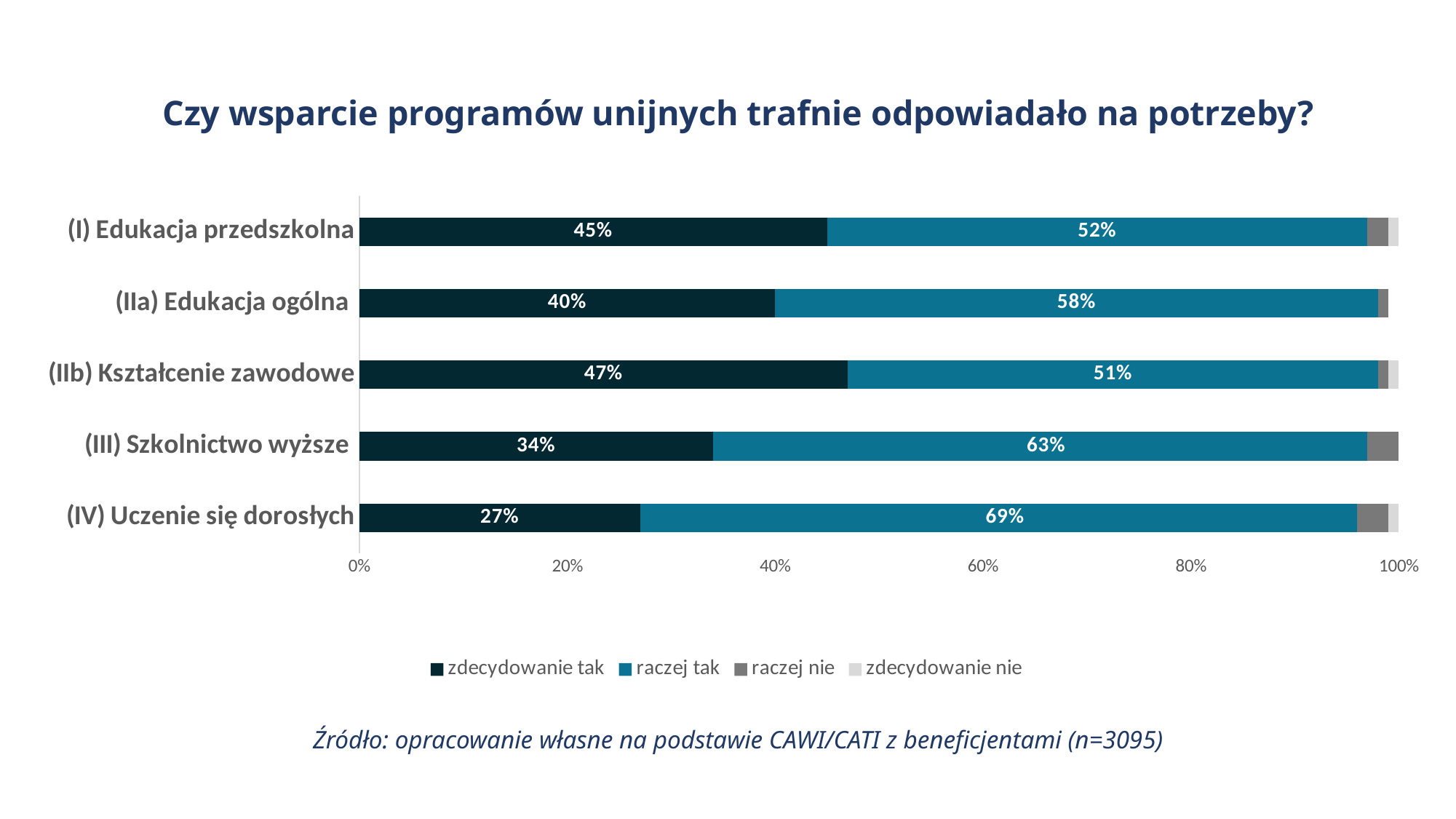
What is the difference in percentage points between the "zdecydowanie tak" values for (I) Edukacja przedszkolna and (IV) Uczenie się dorosłych? 18 percentage points What type of chart is shown on the slide? Stacked bar chart What percentage of respondents answered "zdecydowanie tak" for (I) Edukacja przedszkolna? 45% Which has a larger "zdecydowanie tak" value: (IIa) Edukacja ogólna or (III) Szkolnictwo wyższe? (IIa) Edukacja ogólna How many series does the legend list? 4 What is the "raczej tak" value for (IIb) Kształcenie zawodowe? 51% What is the "raczej tak" value for (IV) Uczenie się dorosłych? 69% How many categories are shown on the chart? 5 Which category has the highest "raczej tak" share? (IV) Uczenie się dorosłych Which category has the lowest "zdecydowanie tak" share? (IV) Uczenie się dorosłych Which category has the highest "zdecydowanie tak" share? (IIb) Kształcenie zawodowe What is the "zdecydowanie tak" value for (III) Szkolnictwo wyższe? 34%